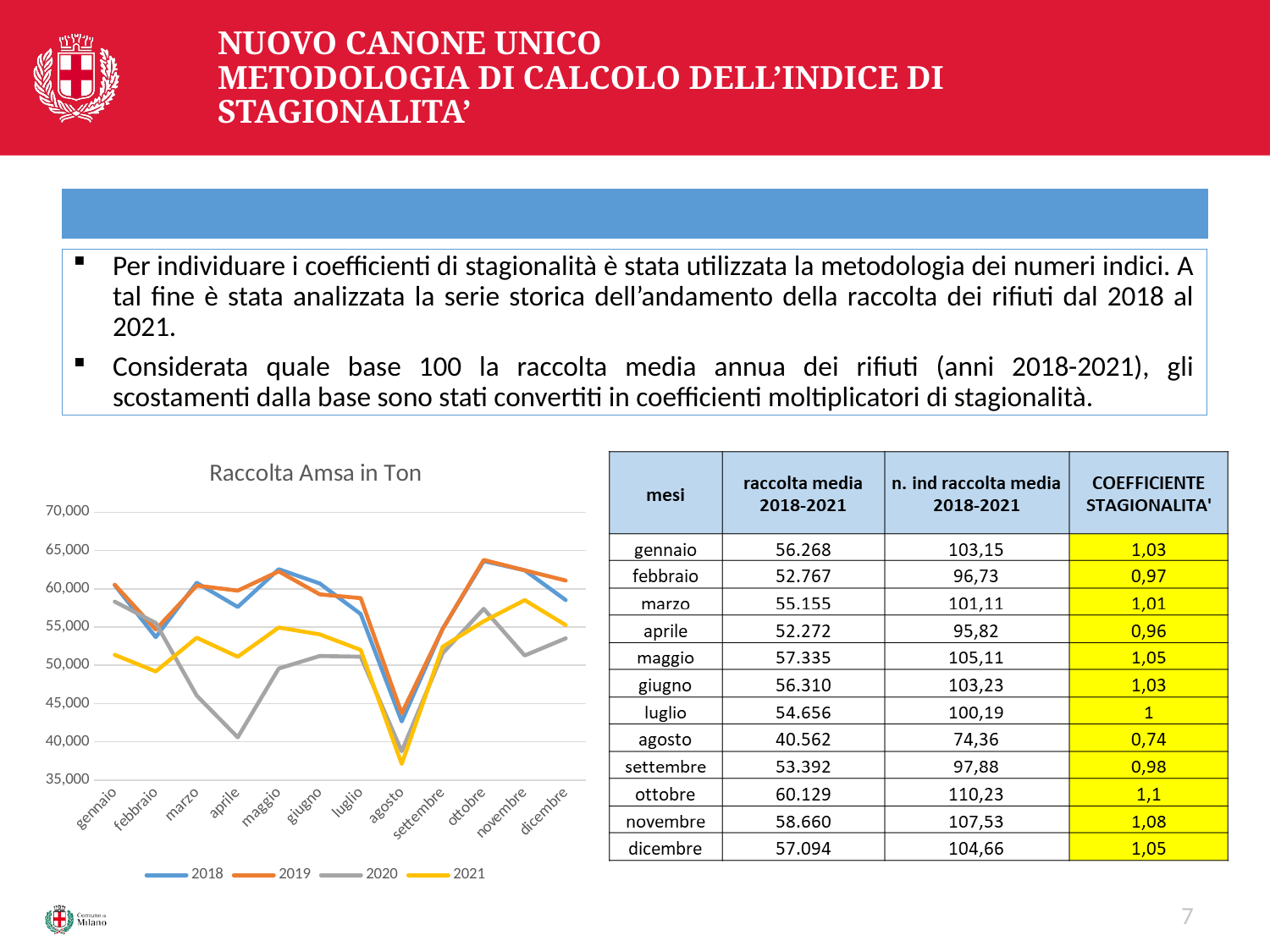
In the "Raccolta Amsa in Ton" chart, is the 2020 value for aprile greater or less than 45,000? less In the "Raccolta Amsa in Ton" chart, which month has the lowest value for the 2019 series? agosto In the "Raccolta Amsa in Ton" chart, which series is higher in aprile, 2019 or 2020? 2019 What kind of chart is "Raccolta Amsa in Ton"? line chart In the "Raccolta Amsa in Ton" chart, is the 2019 value for ottobre greater or less than 60,000? greater How many months are plotted along the x axis of the "Raccolta Amsa in Ton" chart? 12 What is the title of the line chart on the slide? Raccolta Amsa in Ton In the "Raccolta Amsa in Ton" chart, is the 2021 value for agosto greater or less than 40,000? less In the "Raccolta Amsa in Ton" chart, which month has the highest value for the 2019 series? ottobre In the "Raccolta Amsa in Ton" chart, do the values rise or fall from luglio to agosto? fall Which years are listed in the legend of the "Raccolta Amsa in Ton" chart? 2018, 2019, 2020, 2021 How many series does the legend of the "Raccolta Amsa in Ton" chart list? 4